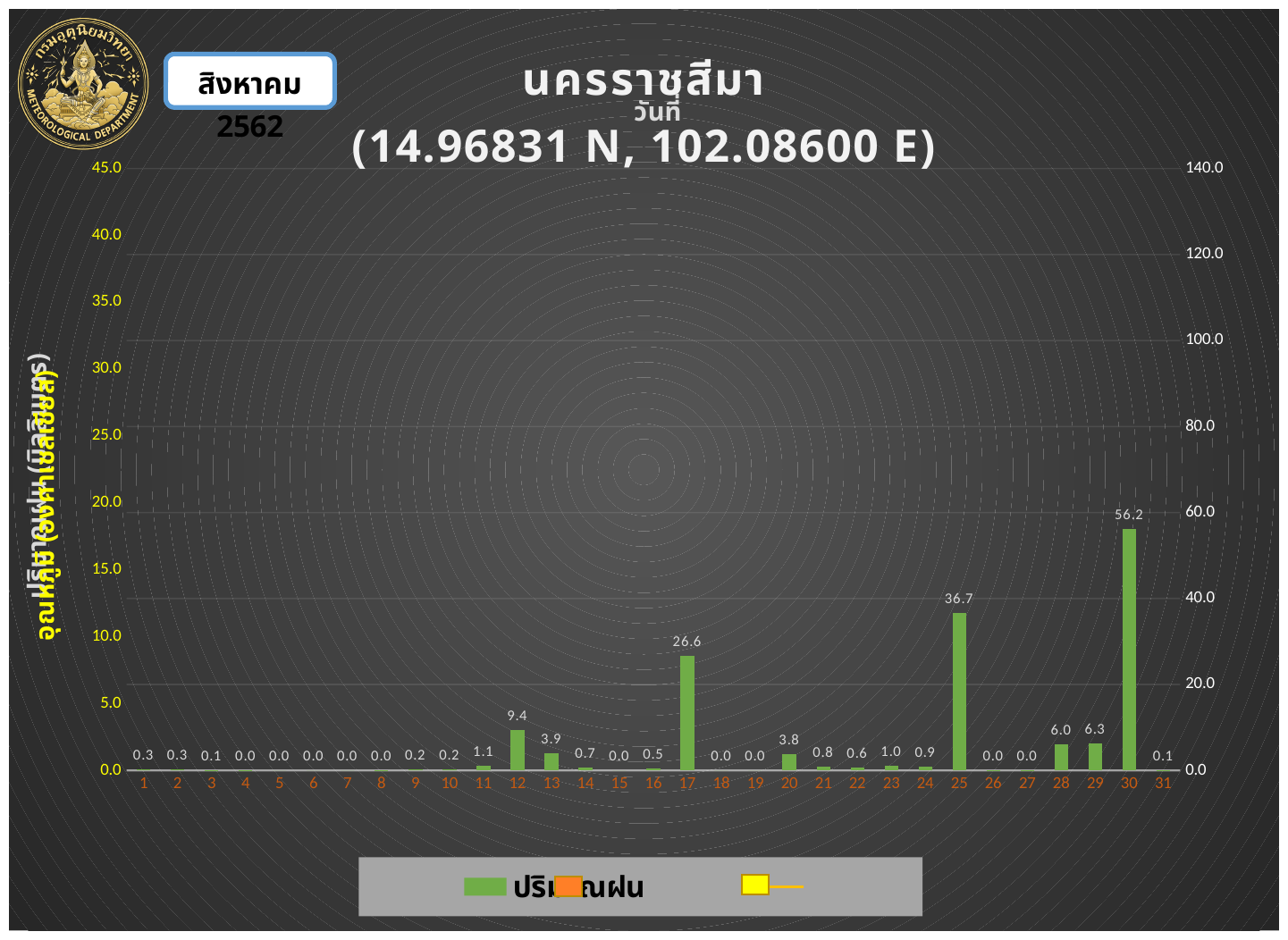
Which day has the highest rainfall value? 30 What is the rainfall value shown for day 30? 56.2 What is the highest tick value shown on the left vertical axis? 45.0 Which is larger, the rainfall value for day 12 or for day 13? day 12 What is the rainfall value shown for day 17? 26.6 How many days are shown on the x axis? 31 What is the difference between the rainfall values for day 30 and day 25? 19.5 What is the rainfall value shown for day 25? 36.7 What kind of chart is shown on the slide? bar chart Which is larger, the rainfall value for day 17 or for day 25? day 25 What is the rainfall value shown for day 12? 9.4 What is the difference between the rainfall values for day 29 and day 28? 0.3